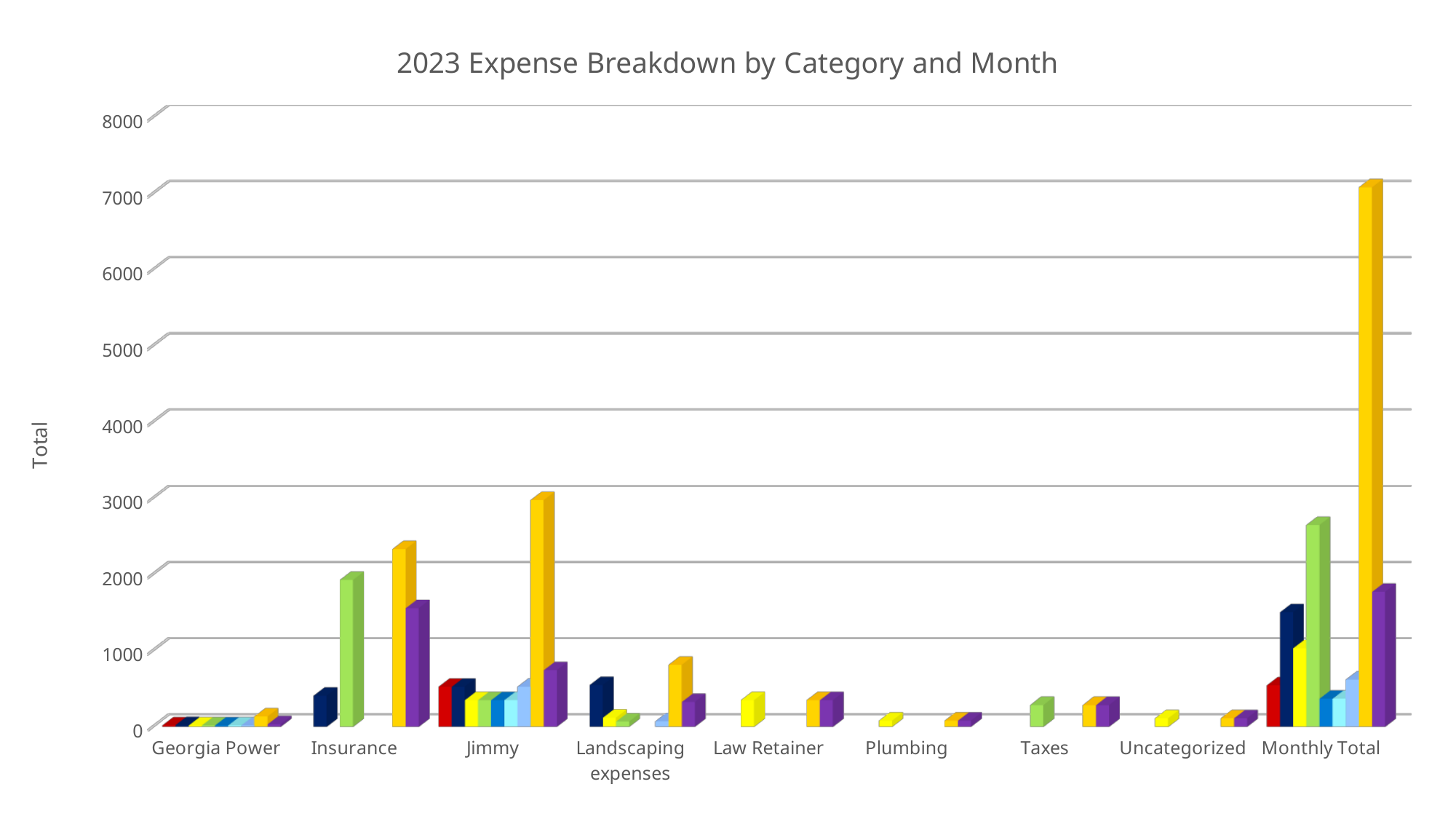
Is the tallest bar for Insurance greater or less than 2000? greater What is the title of the chart? 2023 Expense Breakdown by Category and Month How many categories are shown along the x axis? 9 Is the tallest bar for Monthly Total greater or less than 6000? greater Which category contains the tallest bar in the chart? Monthly Total Is the tallest bar for Jimmy greater or less than 2000? greater What is the highest value shown on the vertical axis? 8000 Which has the taller tallest bar, Insurance or Jimmy? Jimmy What is the label of the vertical axis? Total What kind of chart is shown on the slide? bar chart